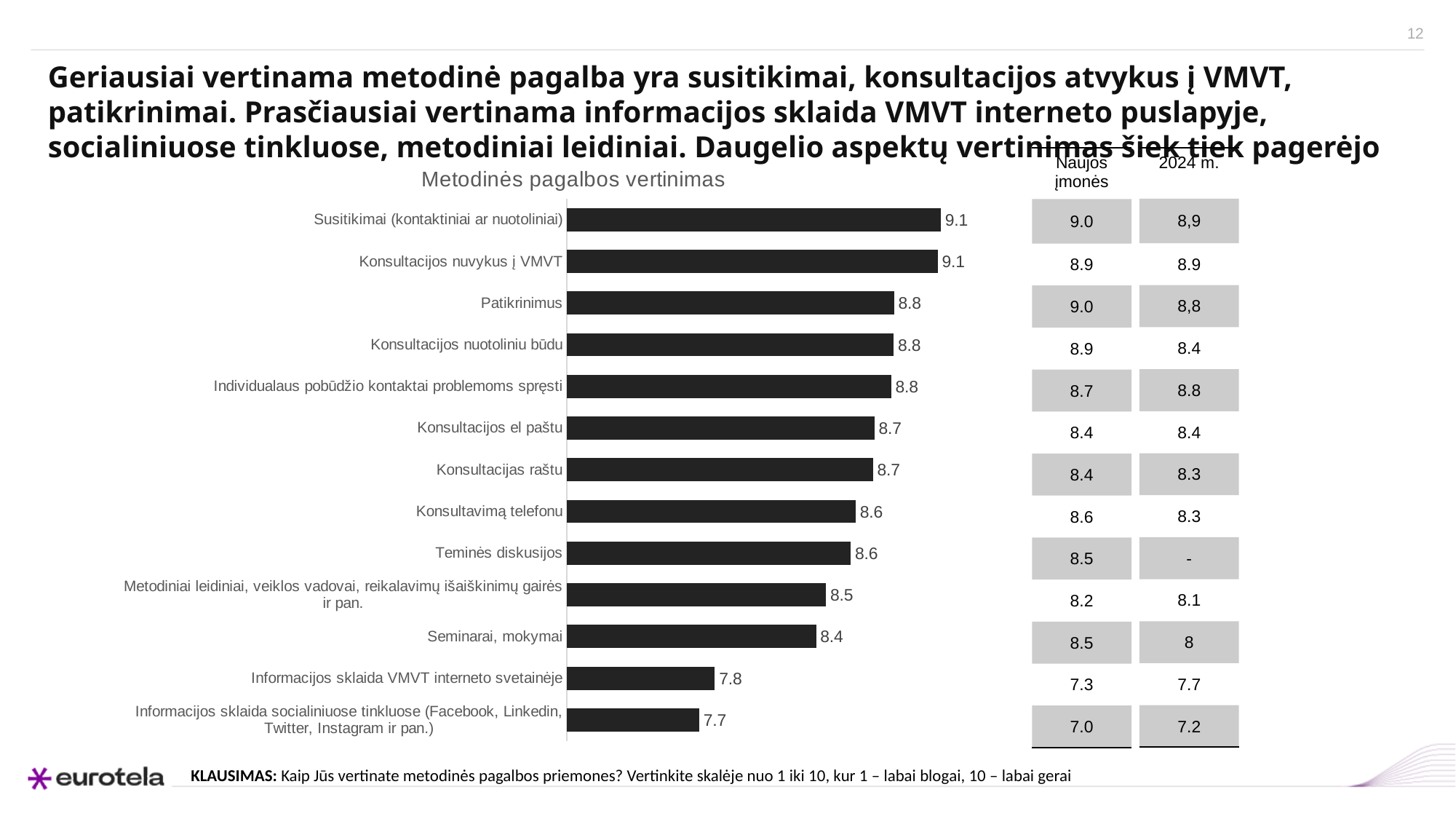
What is the difference between the value for Susitikimai (kontaktiniai ar nuotoliniai) and the value for Informacijos sklaida socialiniuose tinkluose? 1.4 Which is larger: the value for Patikrinimus or the value for Seminarai, mokymai? Patikrinimus What is the value for Konsultavimą telefonu? 8.6 Which category has the lowest value in the chart? Informacijos sklaida socialiniuose tinkluose (Facebook, Linkedin, Twitter, Instagram ir pan.) What is the value for Susitikimai (kontaktiniai ar nuotoliniai)? 9.1 What is the value for Seminarai, mokymai? 8.4 Are the bars ordered from highest to lowest going down the chart? Yes What is the value for Informacijos sklaida VMVT interneto svetainėje? 7.8 What is the title of the chart? Metodinės pagalbos vertinimas What is the highest value shown in the chart? 9.1 What kind of chart is shown on the slide? Bar chart How many categories are shown in the chart? 13